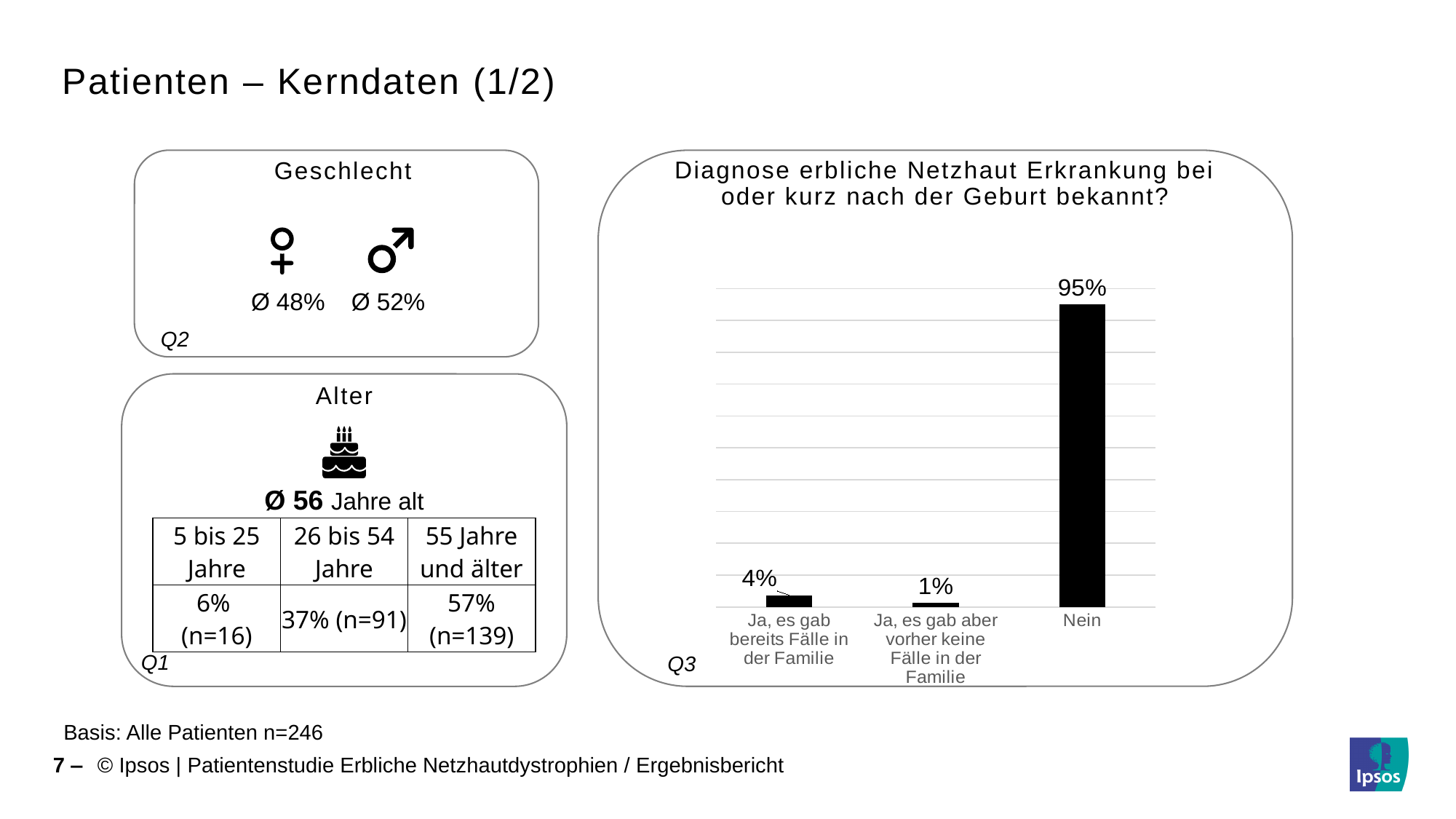
Which category has the highest value in the chart? Nein Which is larger: the value for "Ja, es gab bereits Fälle in der Familie" or for "Ja, es gab aber vorher keine Fälle in der Familie"? Ja, es gab bereits Fälle in der Familie What colour are the bars in the chart? Black Which category has the lowest value in the chart? Ja, es gab aber vorher keine Fälle in der Familie What is the difference between the values for "Ja, es gab bereits Fälle in der Familie" and "Ja, es gab aber vorher keine Fälle in der Familie"? 3% What is the value for "Ja, es gab aber vorher keine Fälle in der Familie" in the chart? 1% What is the difference between the values for "Nein" and "Ja, es gab bereits Fälle in der Familie"? 91% What is the title of the chart on the right of the slide? Diagnose erbliche Netzhaut Erkrankung bei oder kurz nach der Geburt bekannt? What is the value for "Ja, es gab bereits Fälle in der Familie" in the chart? 4% How many categories are shown in the chart? 3 What is the value for "Nein" in the chart "Diagnose erbliche Netzhaut Erkrankung bei oder kurz nach der Geburt bekannt?"? 95% What kind of chart is shown on the slide? Bar chart